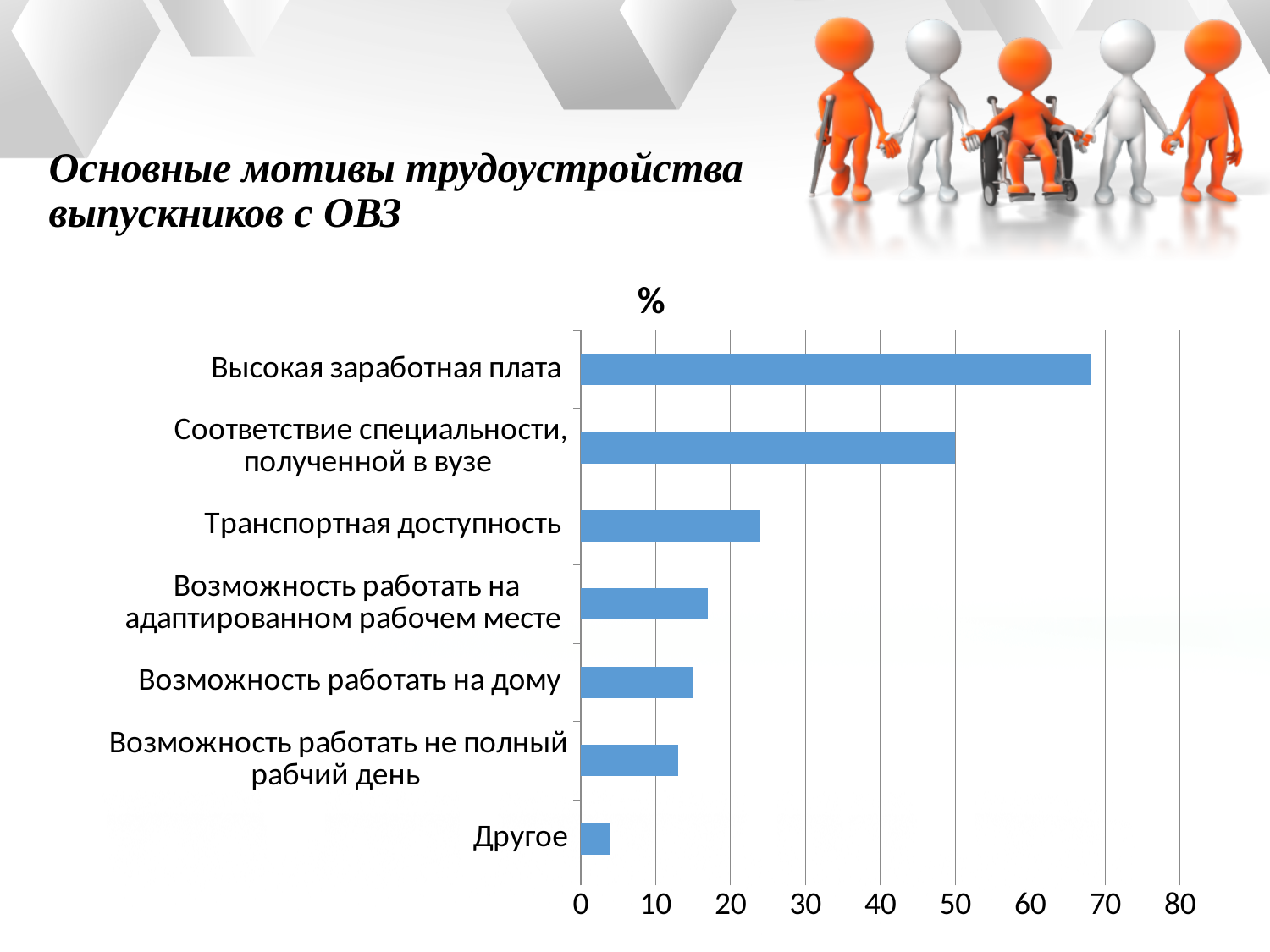
What is the title shown above the chart? % Which category has the highest value? Высокая заработная плата Is the value for Другое greater or less than 10? less Do the bar values increase or decrease going from the top category to the bottom category? decrease What kind of chart is shown on the slide? bar chart Is the value for Возможность работать на адаптированном рабочем месте greater or less than 20? less What is the value for Соответствие специальности, полученной в вузе? 50 Is the value for Высокая заработная плата greater or less than 60? greater Which category has the lowest value? Другое Which is larger: the value for Транспортная доступность or the value for Возможность работать на дому? Транспортная доступность How many categories are plotted in the chart? 7